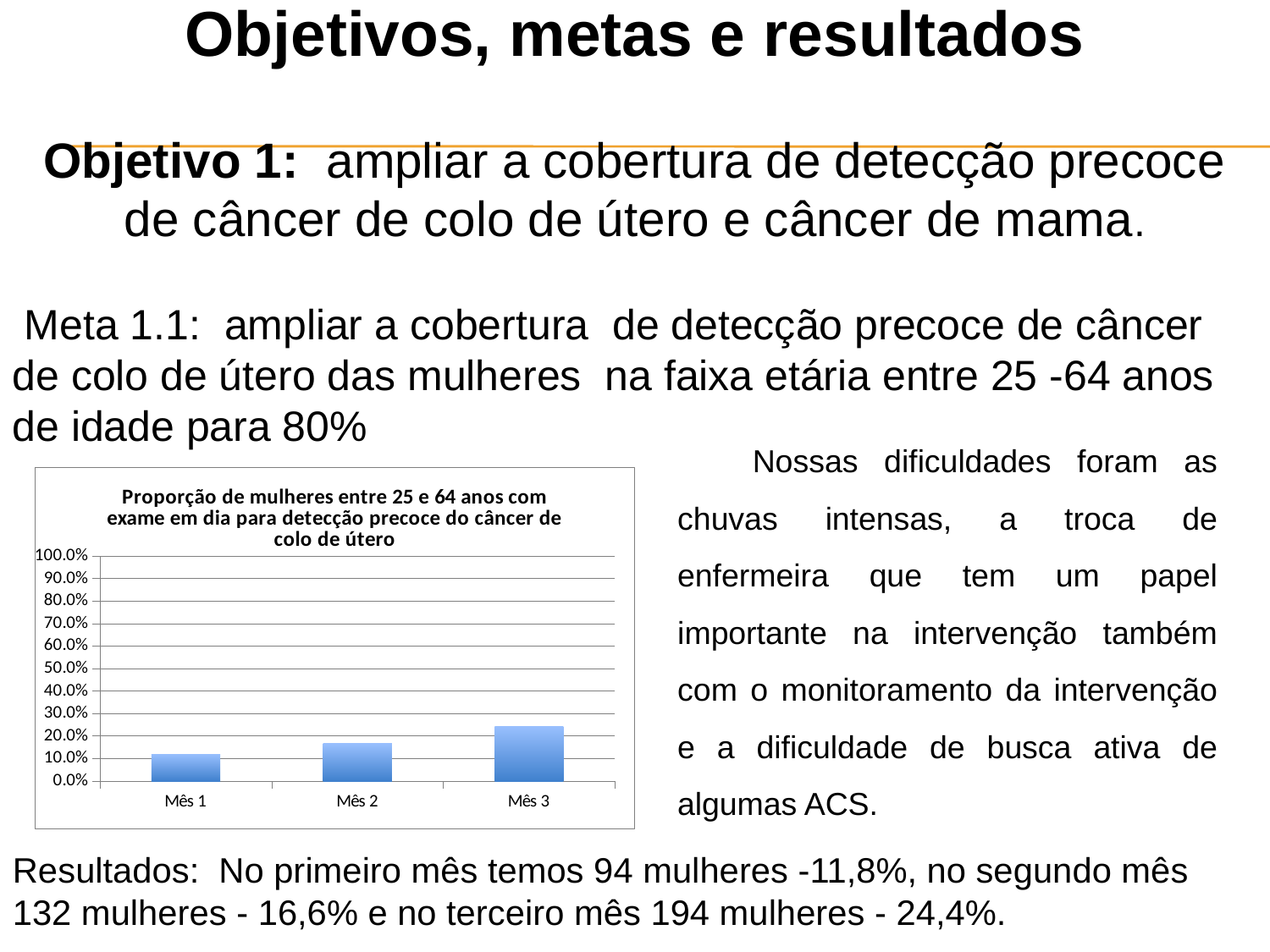
What kind of chart is shown on the slide? bar chart Is the value for Mês 2 greater or less than 10.0%? greater Is the value for Mês 3 greater or less than 30.0%? less How many categories (months) are shown on the x axis of the chart? 3 Which is larger, the value for Mês 2 or the value for Mês 1? Mês 2 What is the title of the chart? Proporção de mulheres entre 25 e 64 anos com exame em dia para detecção precoce do câncer de colo de útero Do the values in the chart rise or fall from Mês 1 to Mês 3? rise Which month has the lowest bar in the chart? Mês 1 Is the value for Mês 1 greater or less than 20.0%? less Which month has the highest bar in the chart? Mês 3 What is the maximum value shown on the chart's y axis? 100.0%